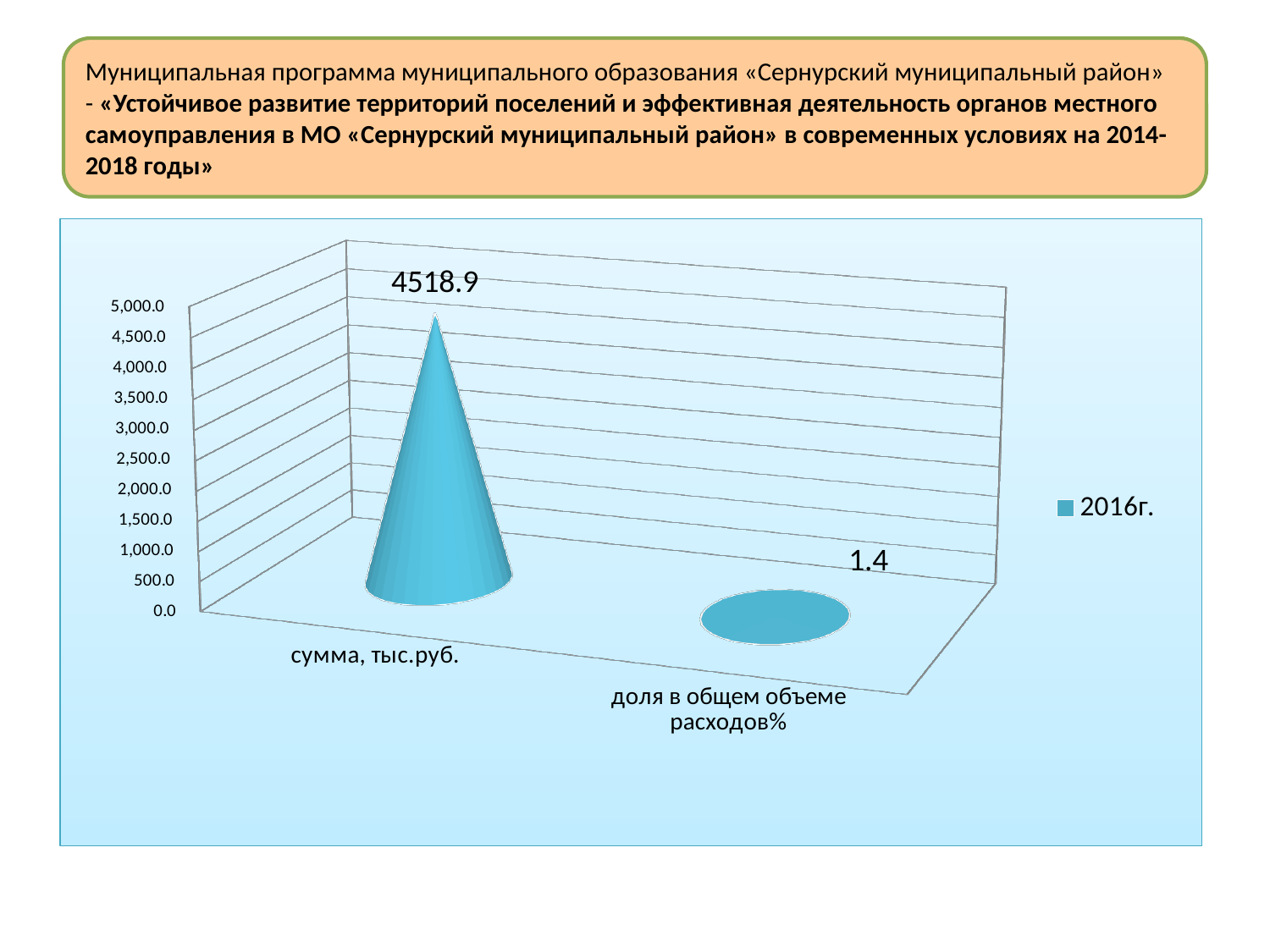
Which is larger: the value for "сумма, тыс.руб." or the value for "доля в общем объеме расходов%"? сумма, тыс.руб. What kind of chart is shown on the slide? bar chart What is the difference between the value for "сумма, тыс.руб." and the value for "доля в общем объеме расходов%"? 4517.5 How many categories are shown on the x axis of the chart? 2 What is the value for "доля в общем объеме расходов%"? 1.4 Is the value for "сумма, тыс.руб." greater or less than 4,000.0? greater How many series does the legend list? 1 What series name is shown in the chart legend? 2016г. Is the value for "доля в общем объеме расходов%" greater or less than 500.0? less Which category has the lowest value? доля в общем объеме расходов% What is the value for "сумма, тыс.руб."? 4518.9 Which category has the highest value? сумма, тыс.руб.